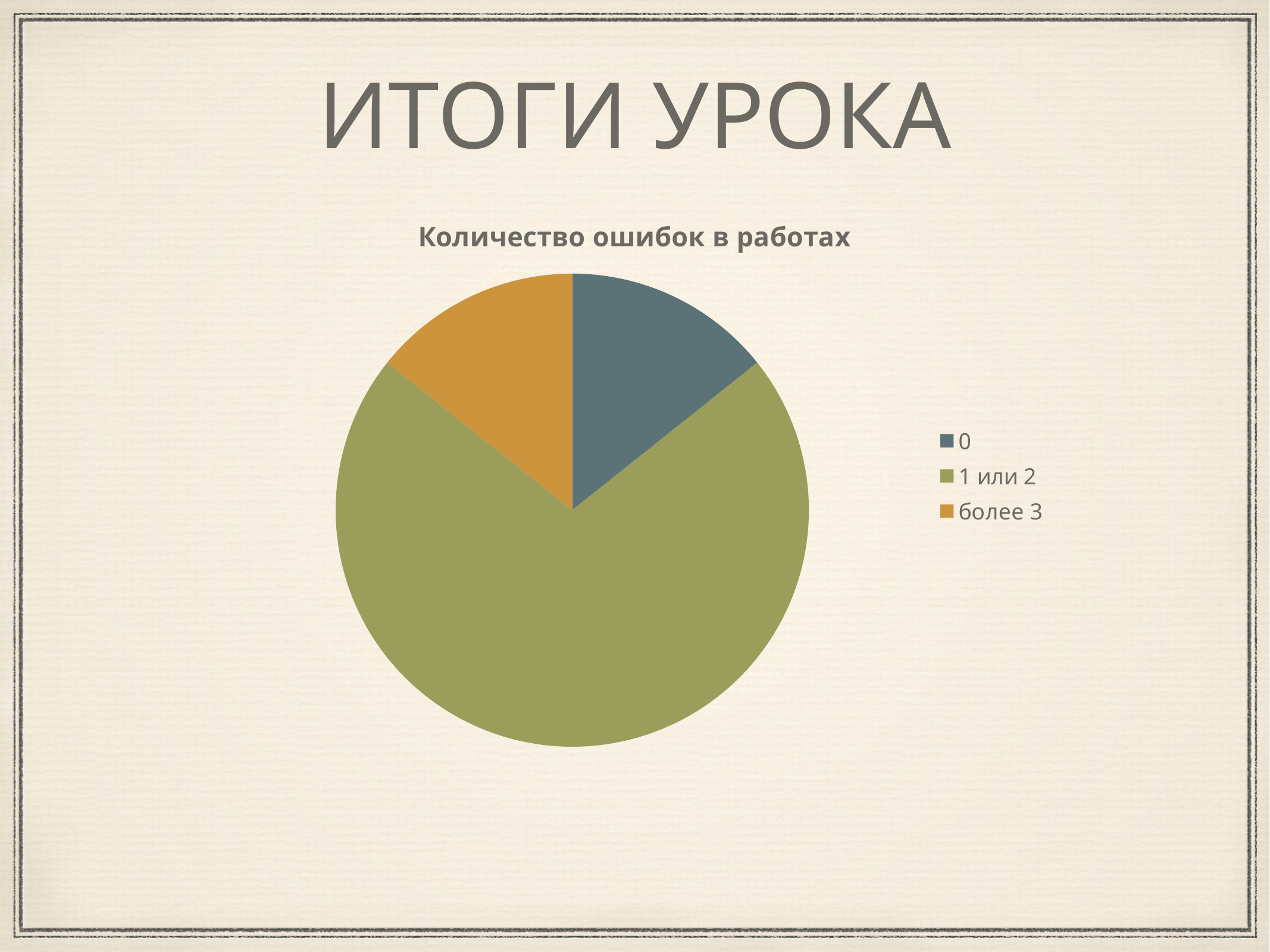
How many slices does the pie chart have? 3 How many entries does the legend list? 3 What is the title of the chart? Количество ошибок в работах Which category has the largest slice of the pie? 1 или 2 Which slice is larger, "1 или 2" or "0"? 1 или 2 Which slice is larger, "1 или 2" or "более 3"? 1 или 2 Which legend entry is shown in orange? более 3 What kind of chart is shown on the slide? pie chart Does the "1 или 2" slice take up more or less than half of the pie? more